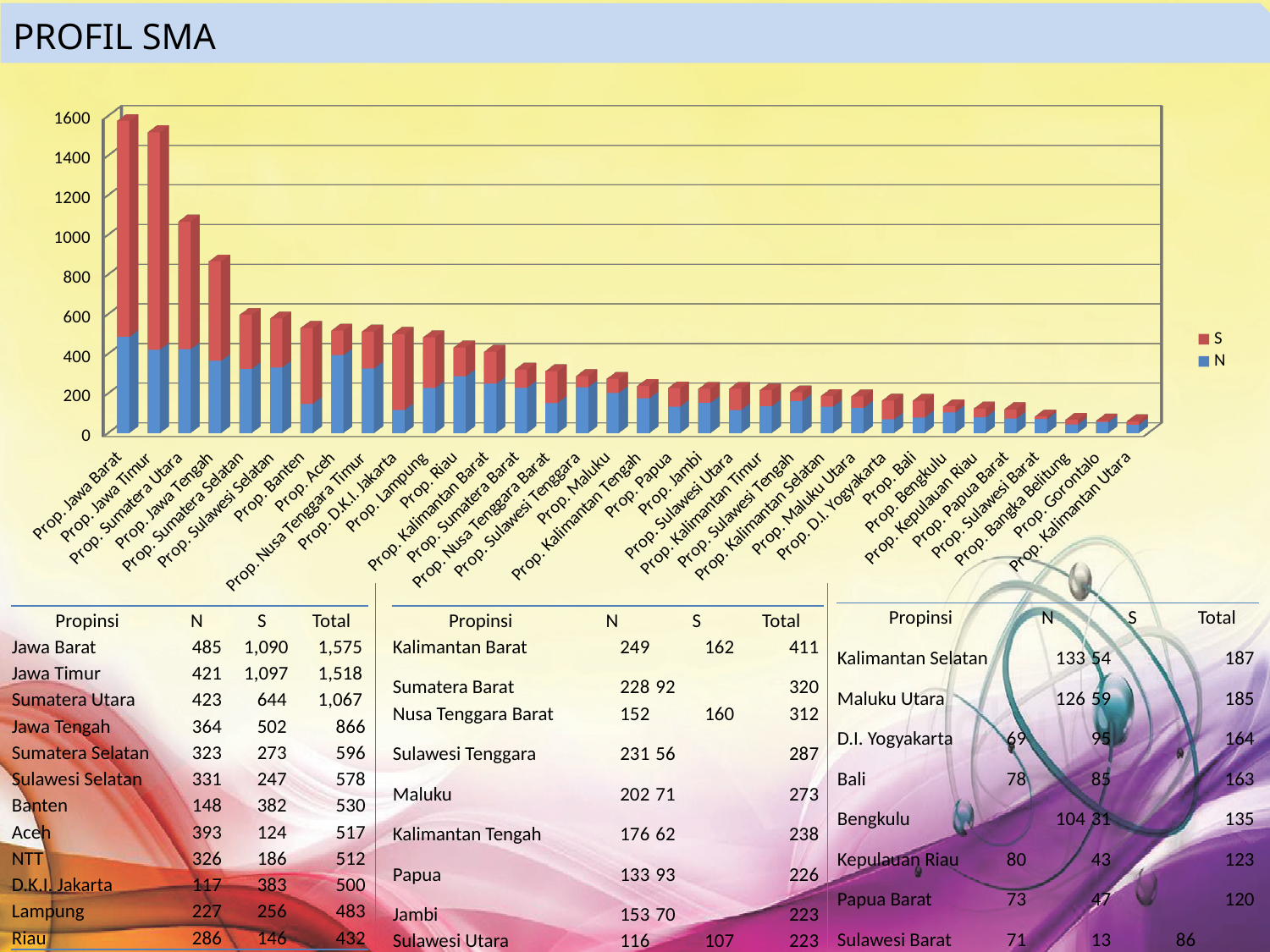
Which has the taller stacked bar, Prop. Jawa Barat or Prop. Sumatera Utara? Prop. Jawa Barat Which colour represents the S series in the chart? red Is the total bar height for Prop. Kalimantan Utara greater or less than 200? less Which has the taller stacked bar, Prop. Jawa Tengah or Prop. Banten? Prop. Jawa Tengah How many provinces (categories) are plotted along the x axis of the chart? 34 Is the total bar height for Prop. Jawa Tengah greater or less than 1000? less Which province has the tallest stacked bar in the chart? Prop. Jawa Barat What are the two series named in the chart legend? S and N How many series does the chart legend list? 2 Is the total bar height for Prop. Jawa Barat greater or less than 1400? greater Do the stacked bar totals rise or fall moving from left to right along the x axis? fall What kind of chart is shown on the slide? stacked bar chart